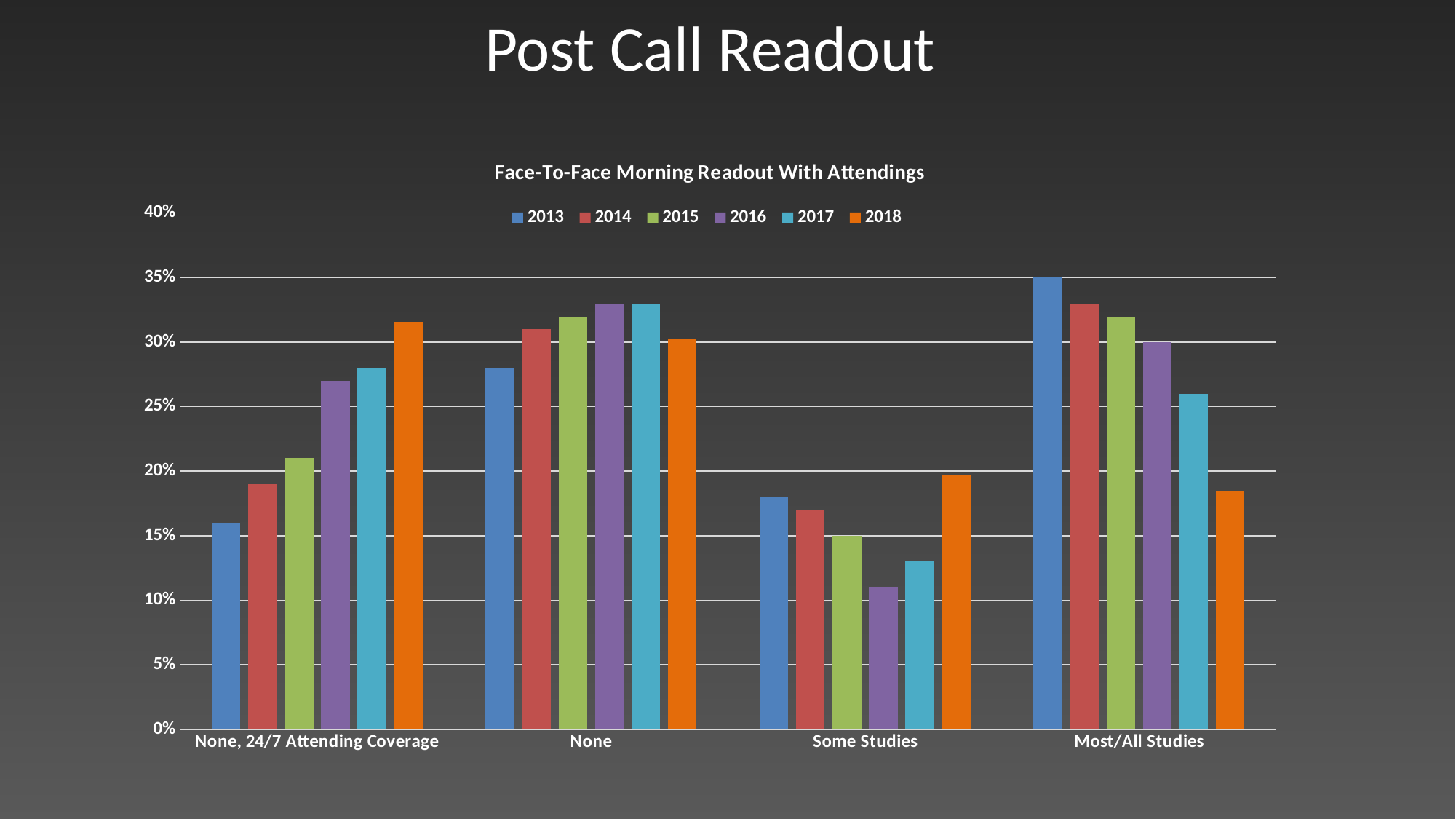
Is the value for 2018 in the None, 24/7 Attending Coverage category greater or less than 30%? greater How many series does the legend list? 6 Is the value for 2013 in the Some Studies category greater or less than 20%? less In the Most/All Studies category, which year has the highest value? 2013 In the Some Studies category, which year has the lowest value? 2016 What is the title of the chart? Face-To-Face Morning Readout With Attendings What kind of chart is shown on the slide? bar chart Is the value for 2016 in the Some Studies category greater or less than 15%? less Which is larger: the 2013 value for None or the 2013 value for Most/All Studies? Most/All Studies In the Most/All Studies category, do the values rise or fall from 2013 to 2018? fall How many categories are shown on the x axis? 4 In the None category, which year has the lowest value? 2013